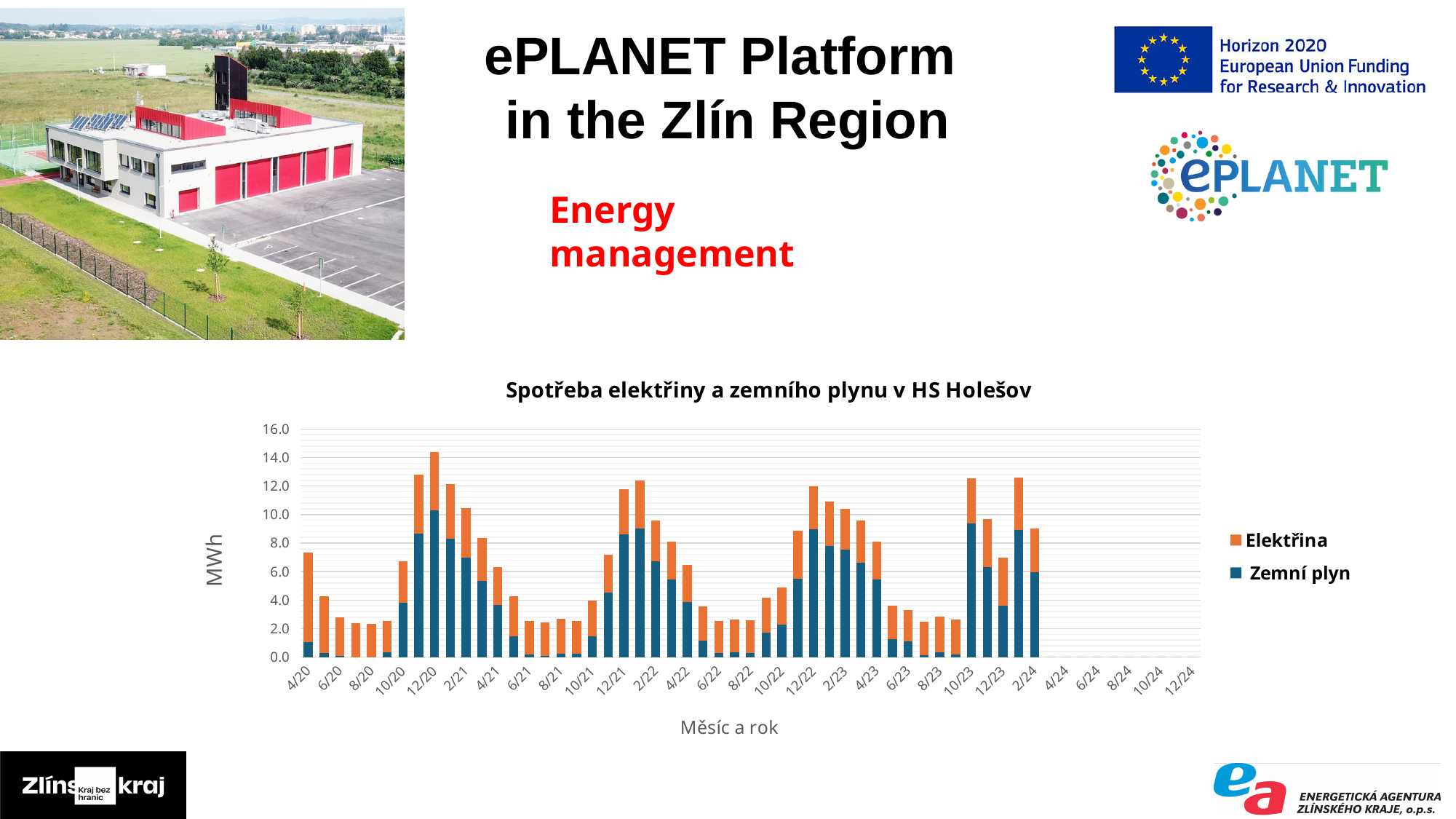
What kind of chart is shown on the slide? stacked bar chart Is the total value for 10/23 greater or less than 10.0? greater How many series does the legend of the chart list? 2 Which series is shown in orange in the chart? Elektřina What is the title of the chart? Spotřeba elektřiny a zemního plynu v HS Holešov What label is shown on the vertical axis of the chart? MWh Is the total value for 4/20 greater or less than 6.0? greater Is the total value for 12/20 greater or less than 12.0? greater Which month has the tallest stacked bar in the chart? 12/20 Which is larger, the total value for 12/21 or the total value for 8/21? 12/21